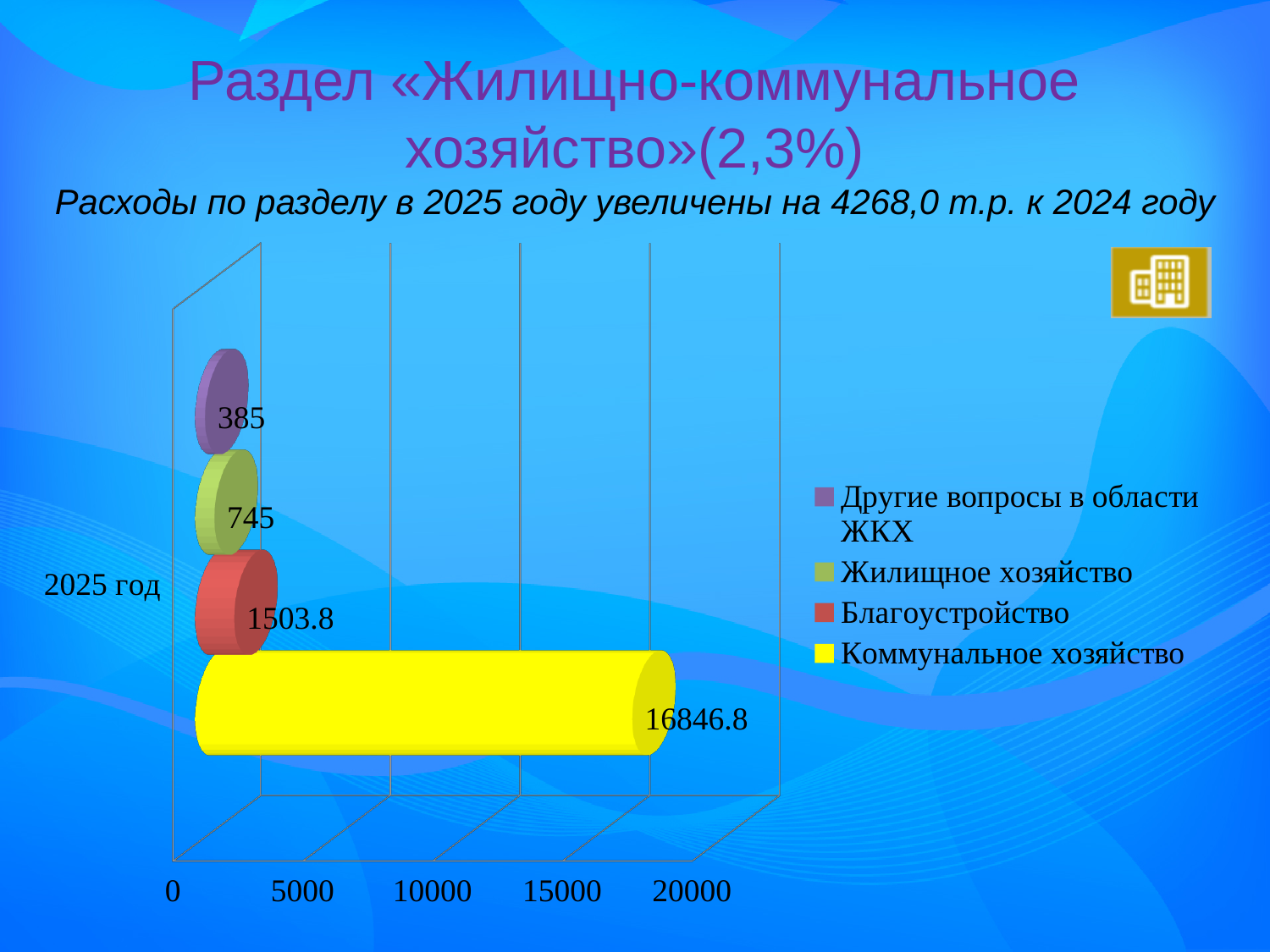
How many series does the legend list? 4 Which is larger, the value for Благоустройство or the value for Жилищное хозяйство? Благоустройство What kind of chart is shown on the slide? bar chart What is the difference between the values for Коммунальное хозяйство and Благоустройство? 15343 What is the difference between the values for Жилищное хозяйство and Другие вопросы в области ЖКХ? 360 What is the value for Благоустройство in 2025 год? 1503.8 Which series has the highest value in 2025 год? Коммунальное хозяйство Is the value for Коммунальное хозяйство greater or less than 15000? greater What is the value for Жилищное хозяйство in 2025 год? 745 What is the value for Коммунальное хозяйство in 2025 год? 16846.8 What is the value for Другие вопросы в области ЖКХ in 2025 год? 385 Which series has the lowest value in 2025 год? Другие вопросы в области ЖКХ